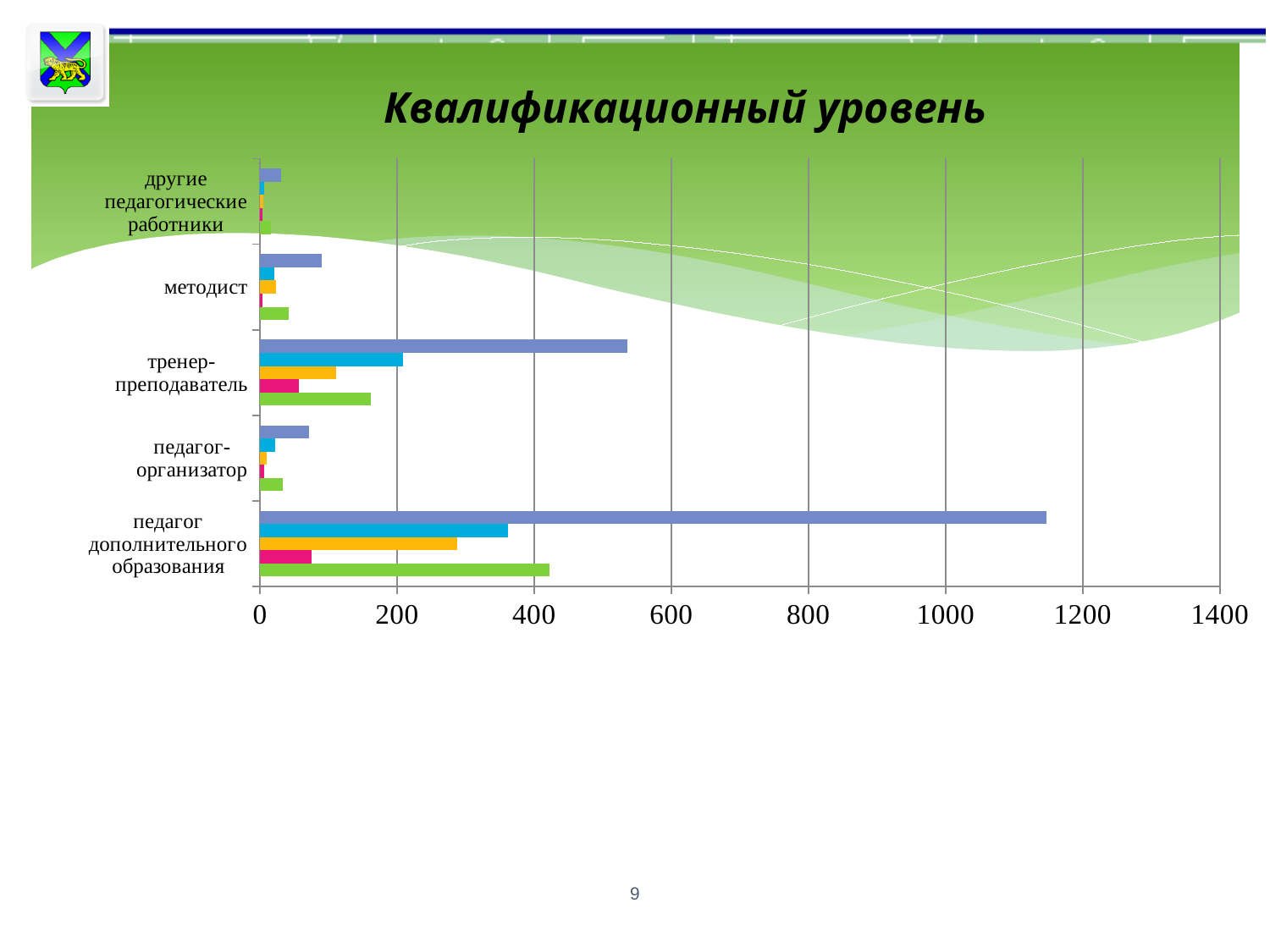
What kind of chart is shown on the slide? bar chart Which category has the shortest bars overall in the chart? другие педагогические работники Which category has the longest bar in the chart? педагог дополнительного образования How many categories are shown on the vertical axis of the chart? 5 What is the title of the chart? Квалификационный уровень Is the longest bar for тренер-преподаватель greater or less than 400? greater How many bars are drawn for each category in the chart? 5 What is the maximum value shown on the horizontal axis of the chart? 1400 Is the longest bar for педагог дополнительного образования greater or less than 1000? greater Is the longest bar for тренер-преподаватель greater or less than 600? less Which category has a longer top bar: тренер-преподаватель or методист? тренер-преподаватель